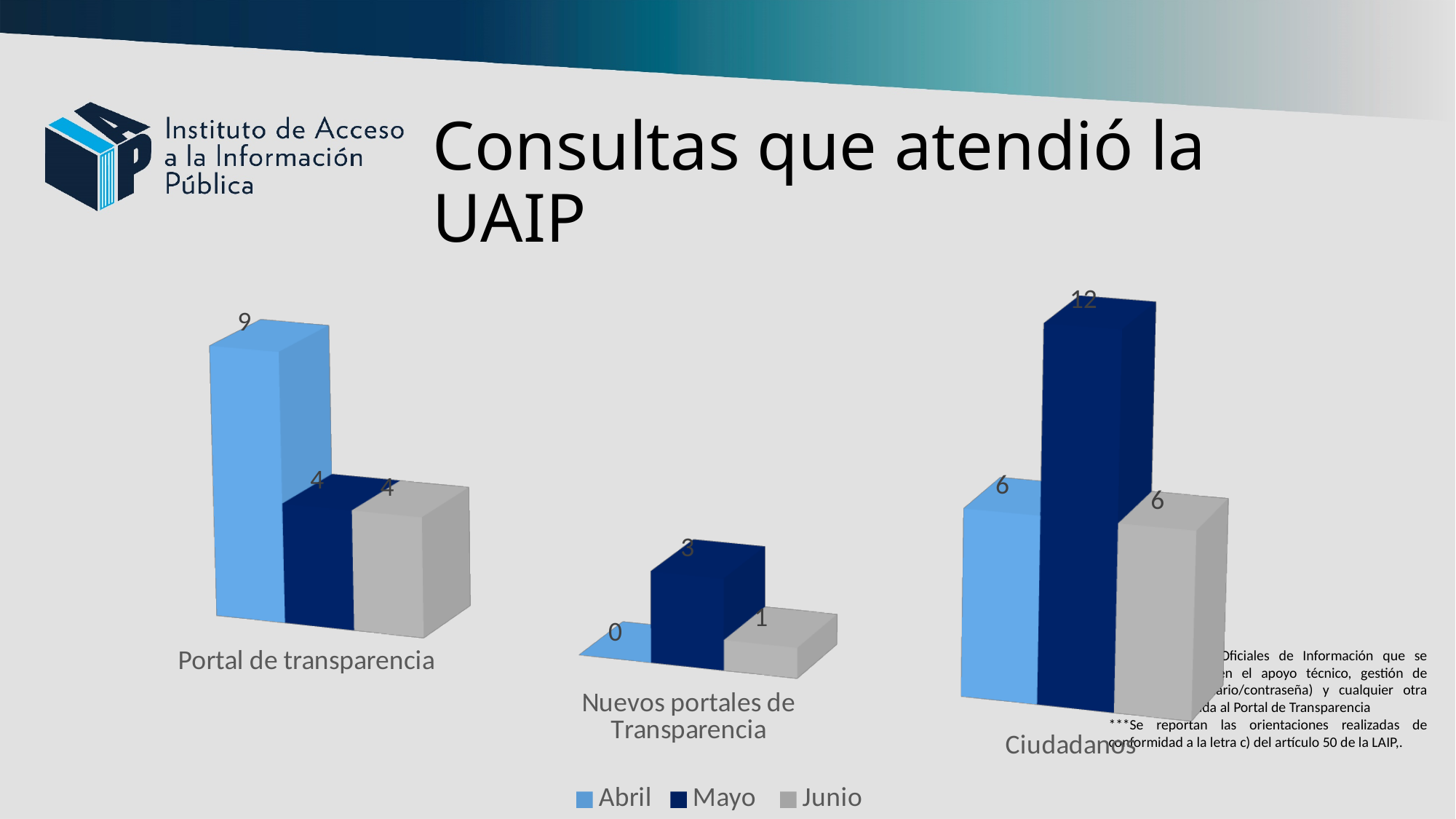
Which is larger: the Abril value for Portal de transparencia or the Abril value for Ciudadanos? Portal de transparencia What is the value for Mayo in the Ciudadanos category? 12 What is the value for Junio in the Nuevos portales de Transparencia category? 1 Which category has the lowest value for Abril? Nuevos portales de Transparencia What kind of chart is shown on the slide? Bar chart How many categories are shown on the x axis? 3 What is the value for Abril in the Nuevos portales de Transparencia category? 0 What is the difference between the Mayo value and the Abril value in the Ciudadanos category? 6 How many series does the legend list? 3 What is the value for Abril in the Portal de transparencia category? 9 Which series is shown in light blue in the legend? Abril Which series has the highest value in the Ciudadanos category? Mayo